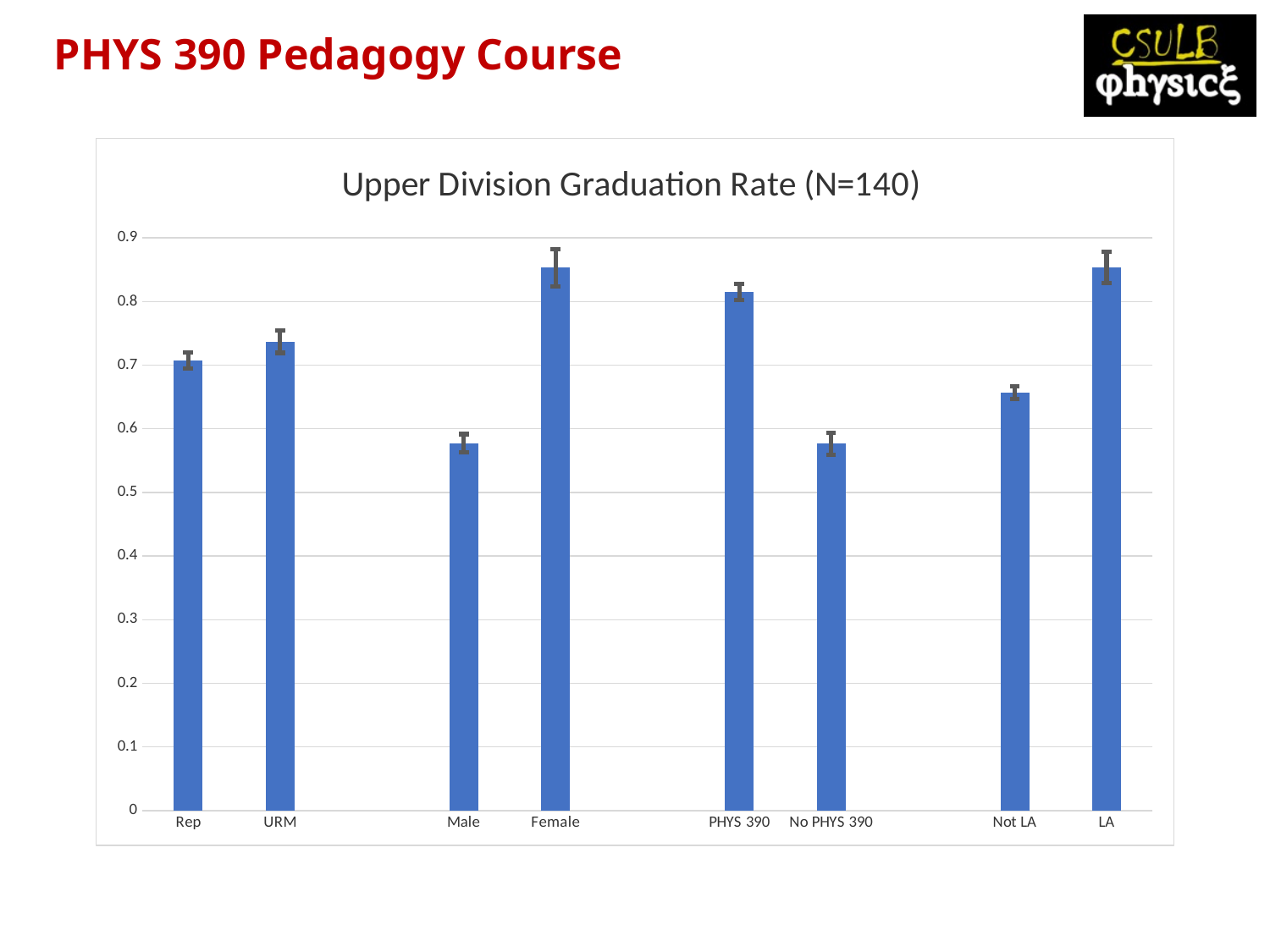
Is the value for PHYS 390 greater or less than 0.8? greater What type of chart is shown on the slide? bar chart Is the value for No PHYS 390 greater or less than 0.6? less Is the value for Not LA greater or less than 0.7? less What is the title of the chart? Upper Division Graduation Rate (N=140) Which has the higher graduation rate, PHYS 390 or No PHYS 390? PHYS 390 How many bars (categories) are plotted in the chart? 8 Which has the higher graduation rate, LA or Not LA? LA Which has the higher graduation rate, Male or Female? Female